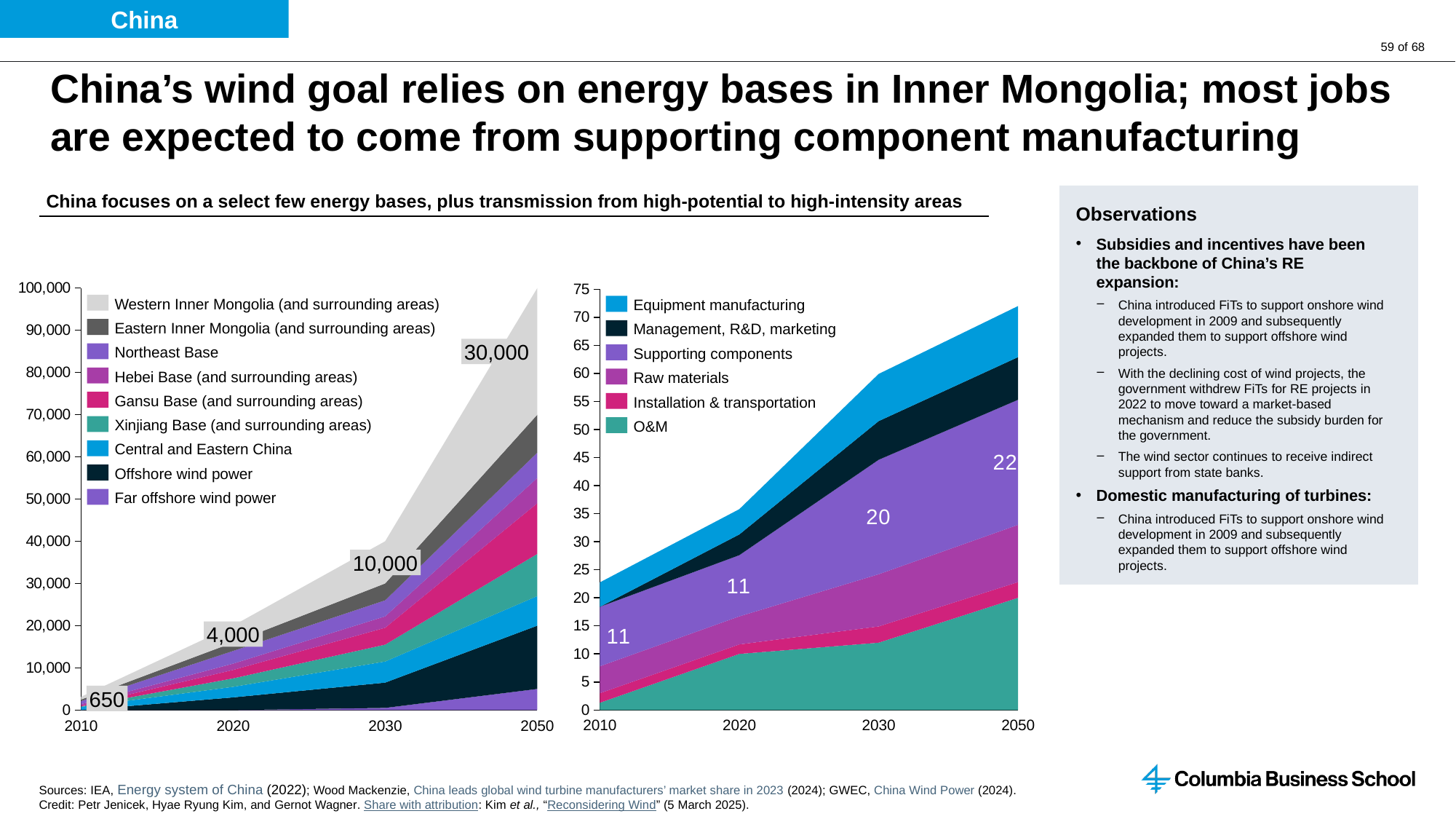
On the right chart, what is the difference between the data labels shown at 2050 and 2030? 2 On the right chart, is the total stacked value in 2010 greater or less than 30? less On the left chart, what data label is shown at 2050? 30,000 What kind of chart is the left chart on the slide? stacked area chart On the left chart, is the total stacked value in 2050 greater or less than 90,000? greater On the right chart, does the total stacked value rise or fall from 2010 to 2050? rise On the right chart, what data label is shown at 2030? 20 On the left chart, what data label is shown at 2010? 650 How many years are labelled on the x axis of the right chart? 4 How many series does the legend of the right chart list? 6 How many series does the legend of the left chart list? 9 On the left chart, what is the difference between the data labels shown at 2050 and 2030? 20,000